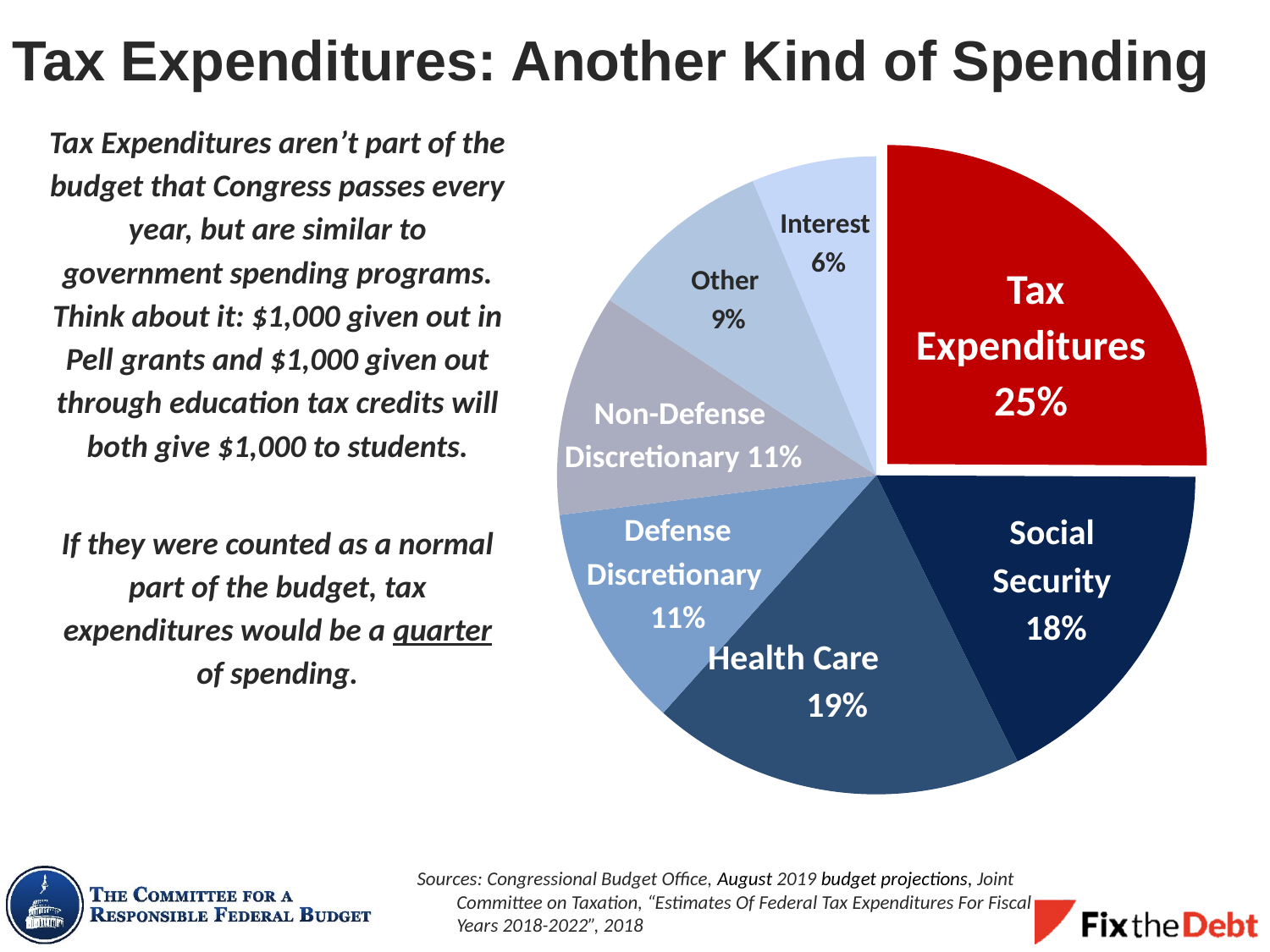
What is the combined share of Defense Discretionary and Non-Defense Discretionary? 22% What share of spending does the Tax Expenditures slice represent? 25% Which is larger, Other or Interest? Other What is the difference in percentage points between Tax Expenditures and Social Security? 7 What colour is the Tax Expenditures slice? Red Which slice of the pie is the largest? Tax Expenditures What percentage is shown for Interest? 6% What percentage is shown for Health Care? 19% Which slice of the pie is the smallest? Interest How many slices does the pie chart have? 7 What percentage is shown for Social Security? 18% What kind of chart is shown on the slide? Pie chart